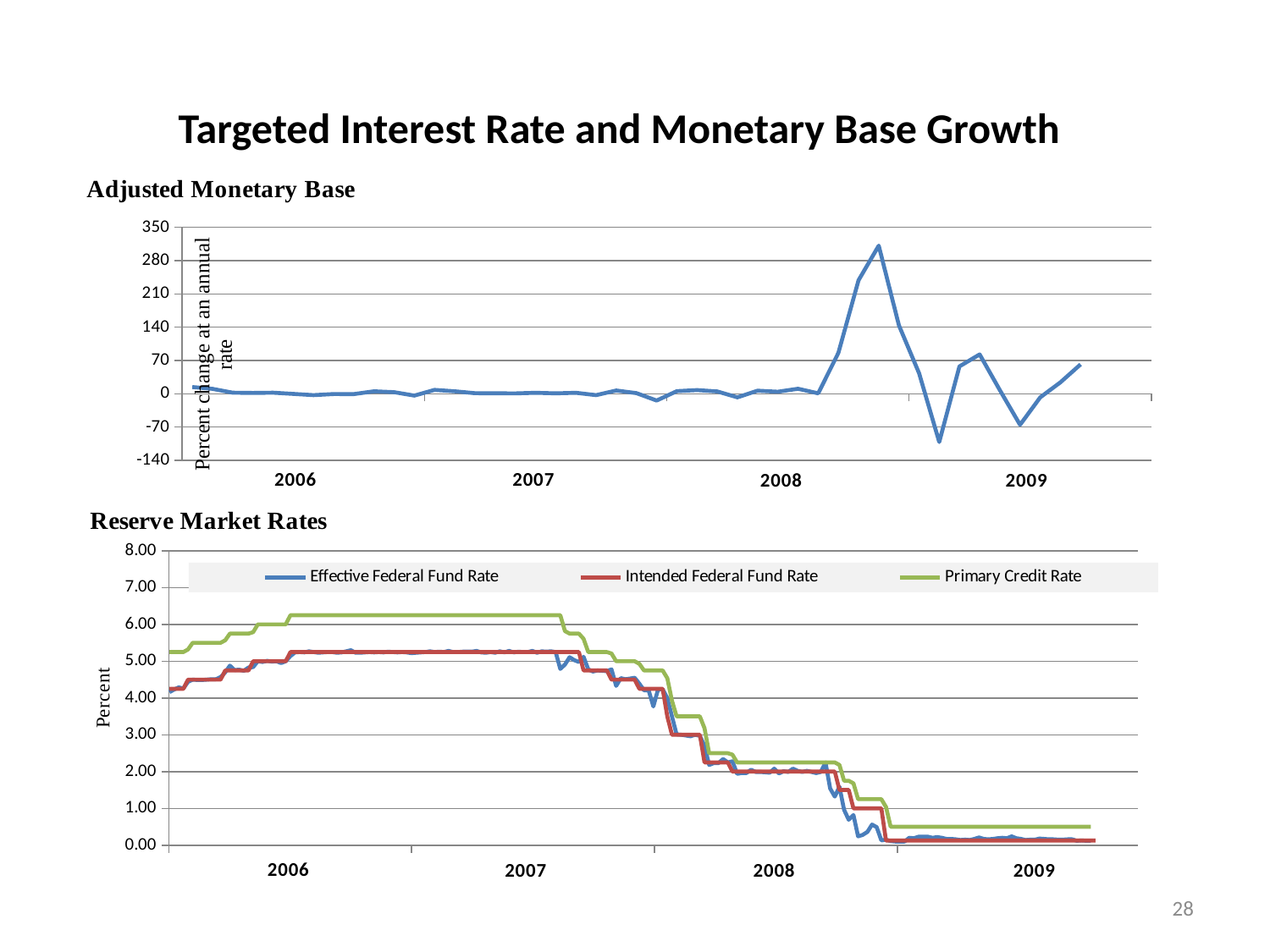
How many series does the legend of the Reserve Market Rates chart list? 3 In the Adjusted Monetary Base chart, is the peak value reached in 2008 greater or less than 280? greater What kind of chart is the Adjusted Monetary Base chart? line chart What is the y-axis label of the Reserve Market Rates chart? Percent In the Reserve Market Rates chart, which series has the highest values throughout the period? Primary Credit Rate In the Reserve Market Rates chart, do the rates rise or fall between 2007 and 2009? fall In the Reserve Market Rates chart, is the peak value of the Primary Credit Rate greater or less than 6.00? greater What is the y-axis label of the Adjusted Monetary Base chart? Percent change at an annual rate In the Reserve Market Rates chart, which is larger during 2007: the Primary Credit Rate or the Intended Federal Fund Rate? Primary Credit Rate In the Adjusted Monetary Base chart, in which year does the series reach its highest point? 2008 In the Adjusted Monetary Base chart, is the lowest value reached in late 2008 greater or less than -70? less